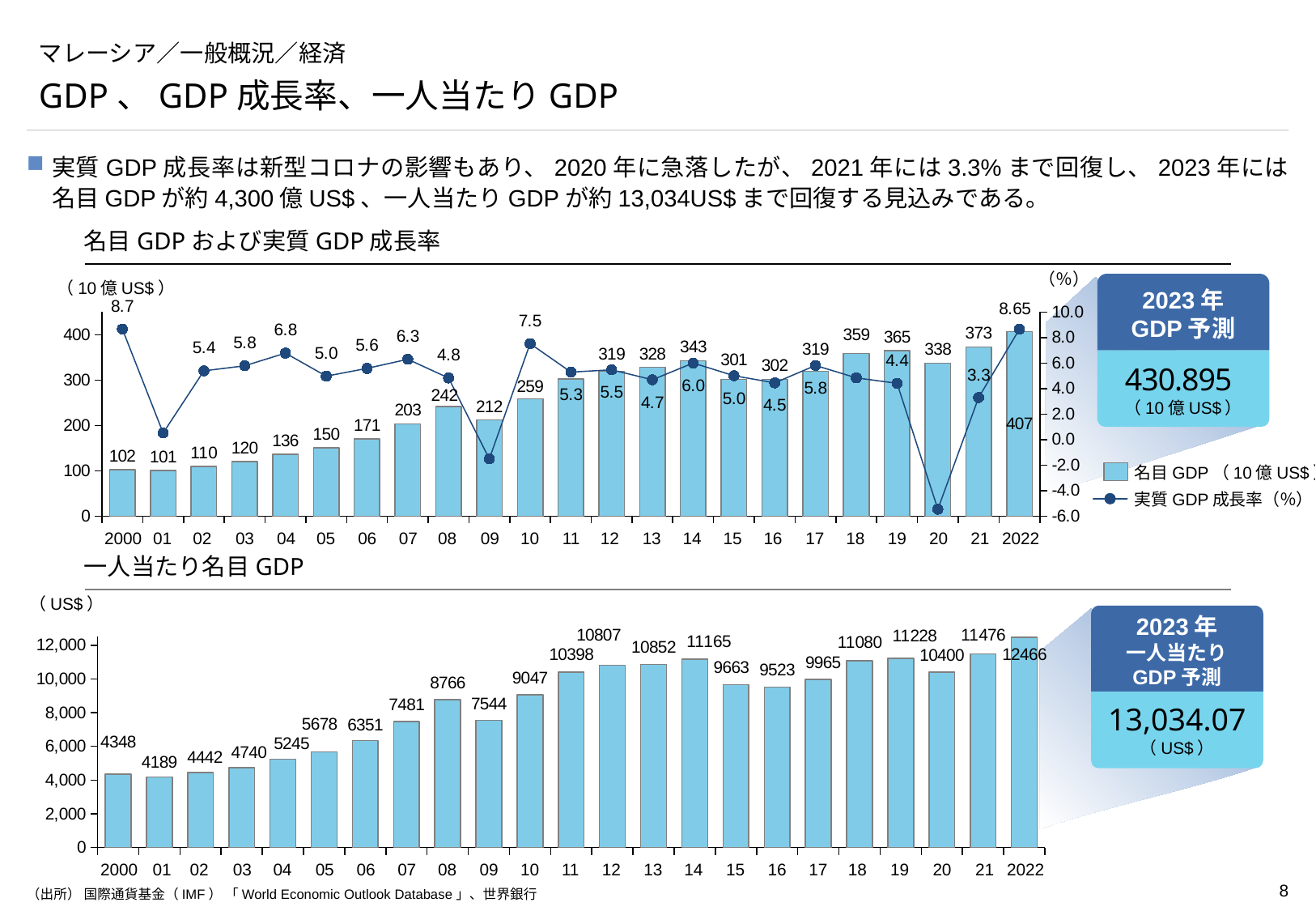
In the top chart (名目GDPおよび実質GDP成長率), how many series does the legend list? 2 In the bottom chart (一人当たり名目GDP), which is larger, the value for 2015 or the value for 2016? 2015 In the bottom chart (一人当たり名目GDP), which year has the lowest value? 2001 In the bottom chart (一人当たり名目GDP), what is the difference between the values for 2009 and 2008? 1222 In the bottom chart (一人当たり名目GDP), what is the value for 2022? 12466 In the top chart (名目GDPおよび実質GDP成長率), what is the difference between the nominal GDP values for 2022 and 2021? 34 In the top chart (名目GDPおよび実質GDP成長率), what is the nominal GDP value for 2022? 407 What kind of chart is the bottom chart (一人当たり名目GDP)? Bar chart In the top chart (名目GDPおよび実質GDP成長率), what is the real GDP growth rate for 2021? 3.3 In the top chart (名目GDPおよび実質GDP成長率), what is the nominal GDP value for 2008? 242 In the top chart (名目GDPおよび実質GDP成長率), is the real GDP growth rate for 2020 greater or less than -4.0? less In the top chart (名目GDPおよび実質GDP成長率), which year has the lowest real GDP growth rate on the line? 2020